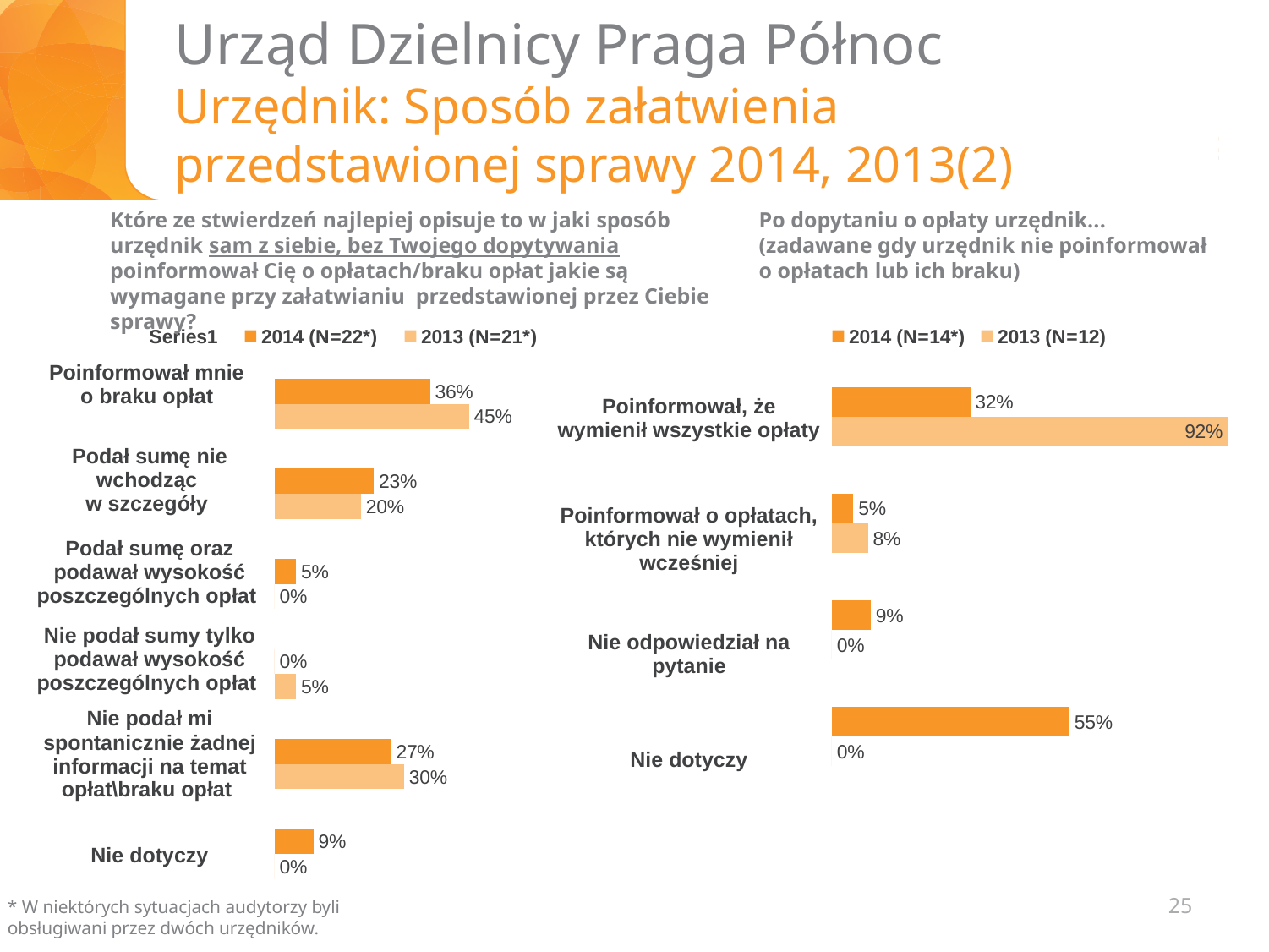
What type of chart is the right chart? Bar chart In the right chart, what is the difference between the 2013 and 2014 values for "Poinformował, że wymienił wszystkie opłaty"? 60 percentage points In the right chart, what is the 2014 value for "Nie dotyczy"? 55% In the left chart, what is the 2013 value for "Nie podał mi spontanicznie żadnej informacji na temat opłat\braku opłat"? 30% In the left chart, what is the difference between the 2013 and 2014 values for "Poinformował mnie o braku opłat"? 9 percentage points How many categories are shown in the right chart? 4 In the left chart, which category has the highest 2013 value? Poinformował mnie o braku opłat In the right chart, which category has the highest 2014 value? Nie dotyczy How many categories are shown in the left chart? 6 In the right chart, what is the 2013 value for "Poinformował, że wymienił wszystkie opłaty"? 92% In the left chart, which is larger for "Podał sumę nie wchodząc w szczegóły": the 2014 value or the 2013 value? 2014 In the left chart, what is the 2014 value for "Poinformował mnie o braku opłat"? 36%